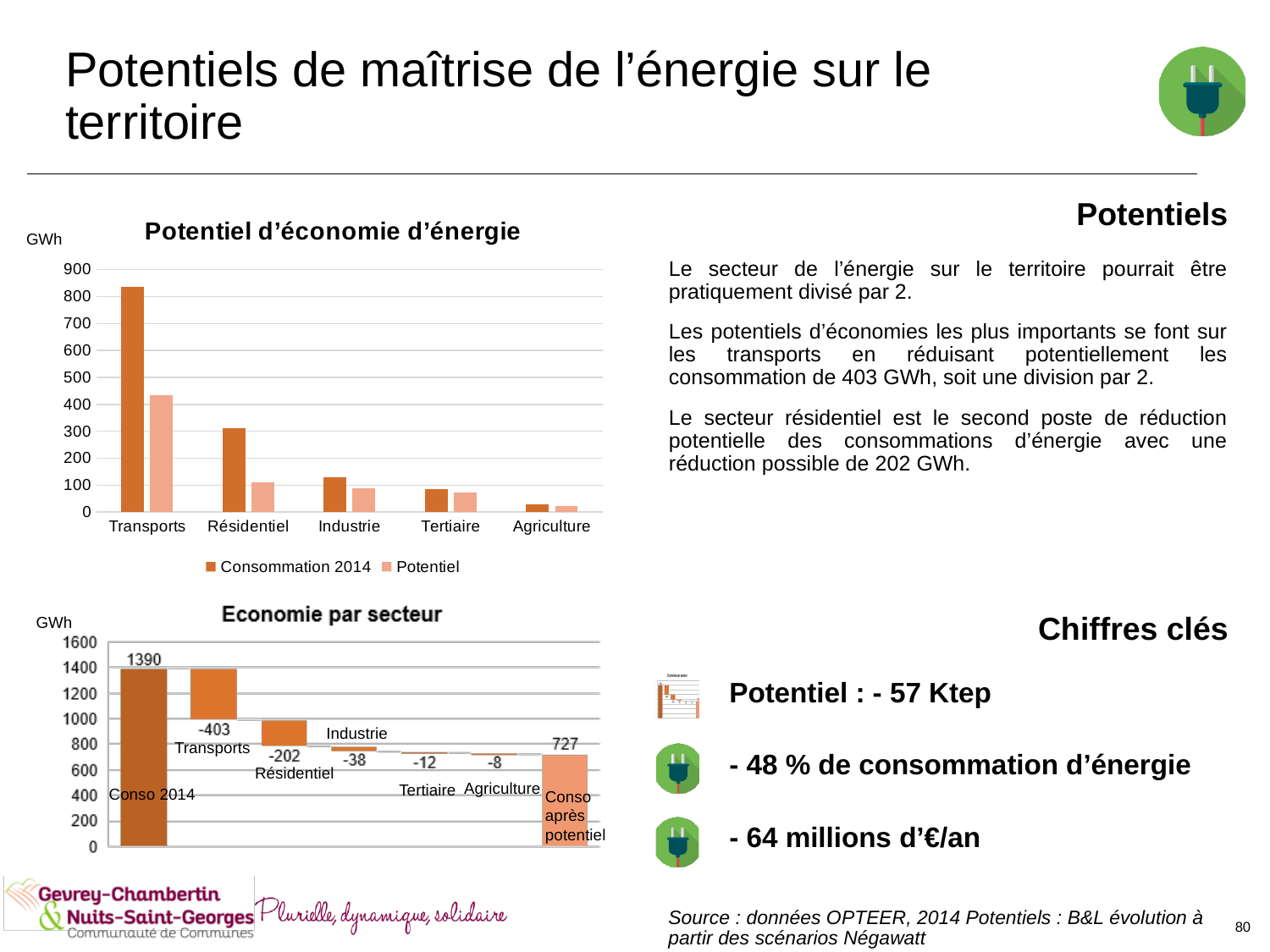
In the chart 'Potentiel d’économie d’énergie', is the Consommation 2014 value for Transports greater or less than 800? greater In the chart 'Potentiel d’économie d’énergie', is the Potentiel value for Résidentiel greater or less than 200? less In the chart 'Potentiel d’économie d’énergie', which category has the highest Consommation 2014 value? Transports In the chart 'Economie par secteur', what is the difference between Conso 2014 and Conso après potentiel? 663 In the chart 'Economie par secteur', what is the value labelled for Transports? -403 In the chart 'Economie par secteur', what is the value labelled for Conso 2014? 1390 In the chart 'Potentiel d’économie d’énergie', which is larger for Résidentiel: Consommation 2014 or Potentiel? Consommation 2014 In the chart 'Potentiel d’économie d’énergie', how many series does the legend list? 2 In the chart 'Economie par secteur', what is the value labelled for Conso après potentiel? 727 In the chart 'Potentiel d’économie d’énergie', how many categories are shown on the x axis? 5 In the chart 'Economie par secteur', which sector has the smallest reduction? Agriculture In the chart 'Potentiel d’économie d’énergie', which category has the lowest Consommation 2014 value? Agriculture